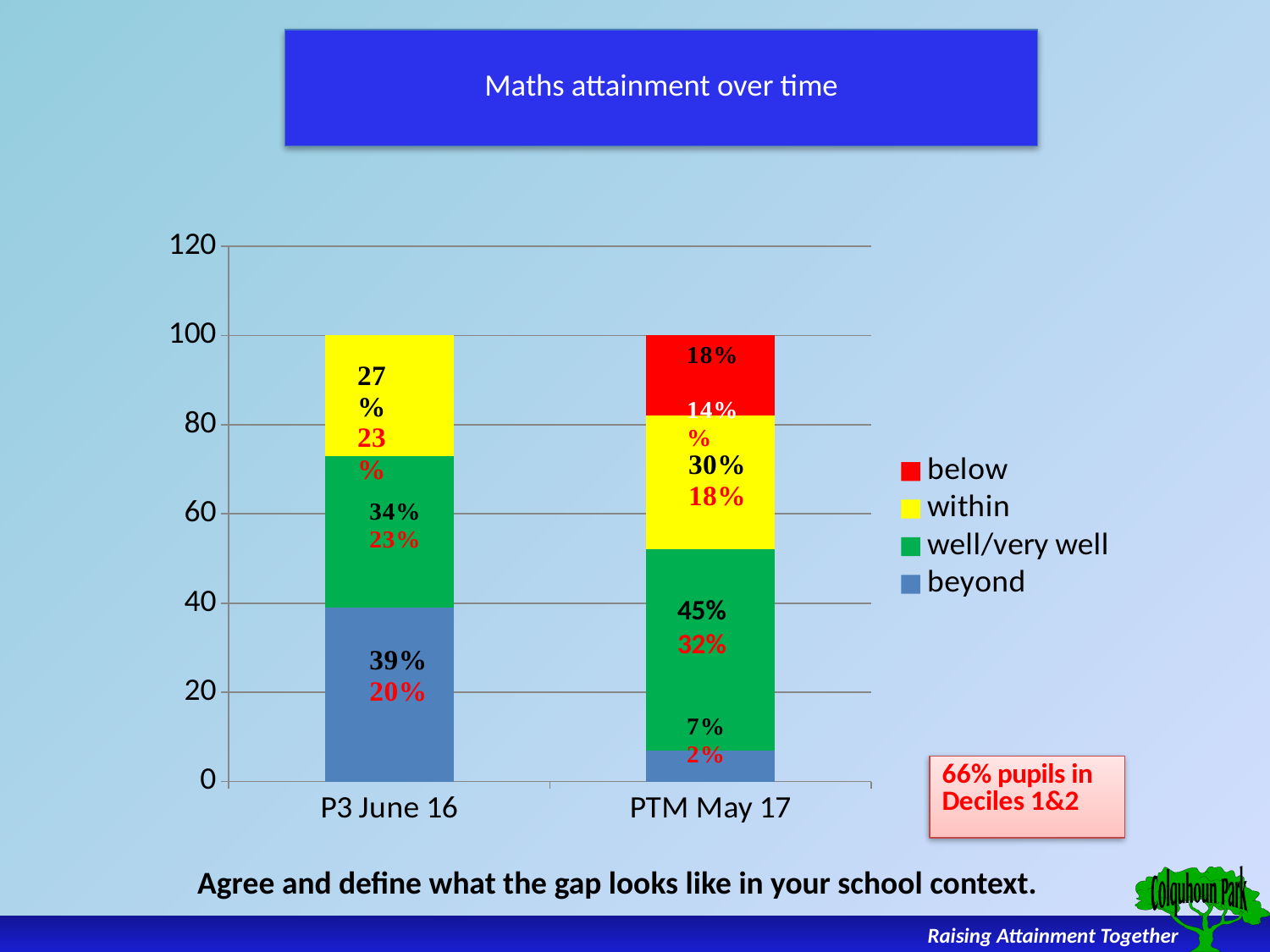
What is the black data label on the 'well/very well' segment for PTM May 17? 45% How many series does the chart legend list? 4 Which category has the larger 'beyond' segment, P3 June 16 or PTM May 17? P3 June 16 What is the black data label on the 'beyond' segment for P3 June 16? 39% How many categories are shown on the x axis of the chart? 2 Is the top of the 'beyond' segment for PTM May 17 greater or less than 20 on the axis? less Which series are listed in the chart legend, from top to bottom? below, within, well/very well, beyond What type of chart is shown on the slide? Stacked bar chart Using the black data labels, what is the difference between the 'well/very well' values for PTM May 17 and P3 June 16? 11 percentage points What is the black data label on the 'within' segment for P3 June 16? 27% What is the black data label on the 'below' segment for PTM May 17? 18% What is the title of the chart? Maths attainment over time